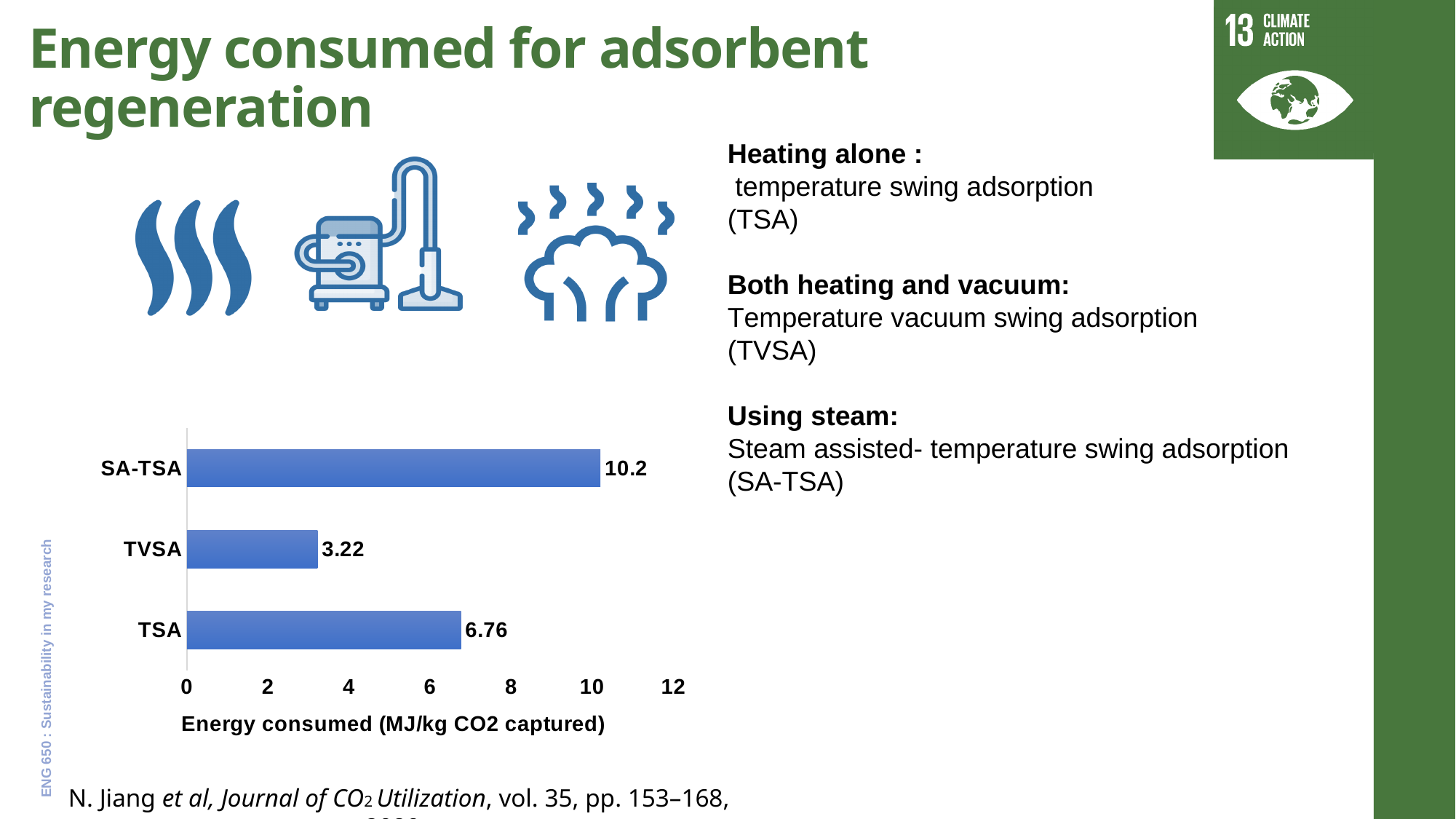
Which regeneration method consumes the least energy? TVSA Which regeneration method consumes the most energy? SA-TSA Which consumes more energy, TSA or TVSA? TSA Is the value for SA-TSA greater or less than 8? greater What is the energy consumed for TVSA? 3.22 What is the energy consumed for SA-TSA? 10.2 What is the difference in energy consumed between TSA and TVSA? 3.54 How many regeneration methods are shown in the chart? 3 What is the difference in energy consumed between SA-TSA and TSA? 3.44 What is the energy consumed for TSA? 6.76 What is the label of the horizontal axis of the chart? Energy consumed (MJ/kg CO2 captured) What kind of chart is shown on the slide? bar chart